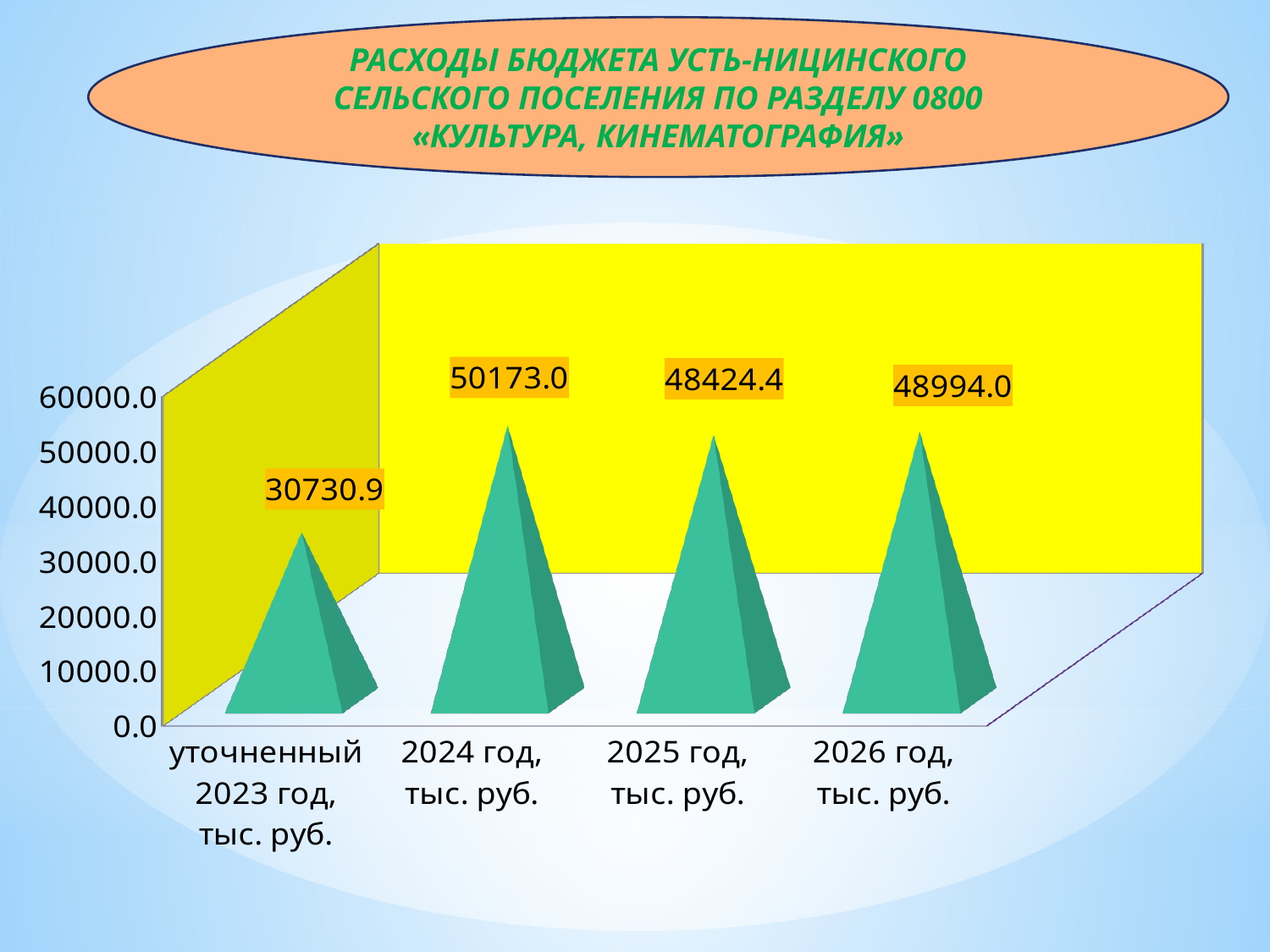
Is the value for уточненный 2023 год greater or less than 40000.0? less What kind of chart is shown on the slide? bar chart What is the value for уточненный 2023 год, тыс. руб.? 30730.9 How many categories are shown on the x axis? 4 Which is larger, the value for 2024 год or the value for 2025 год? 2024 год, тыс. руб. What is the difference between the values for 2024 год and 2025 год? 1748.6 Which category has the highest value? 2024 год, тыс. руб. What is the value for 2025 год, тыс. руб.? 48424.4 What is the value for 2024 год, тыс. руб.? 50173.0 What is the difference between the values for 2024 год and уточненный 2023 год? 19442.1 What is the value for 2026 год, тыс. руб.? 48994.0 Which category has the lowest value? уточненный 2023 год, тыс. руб.